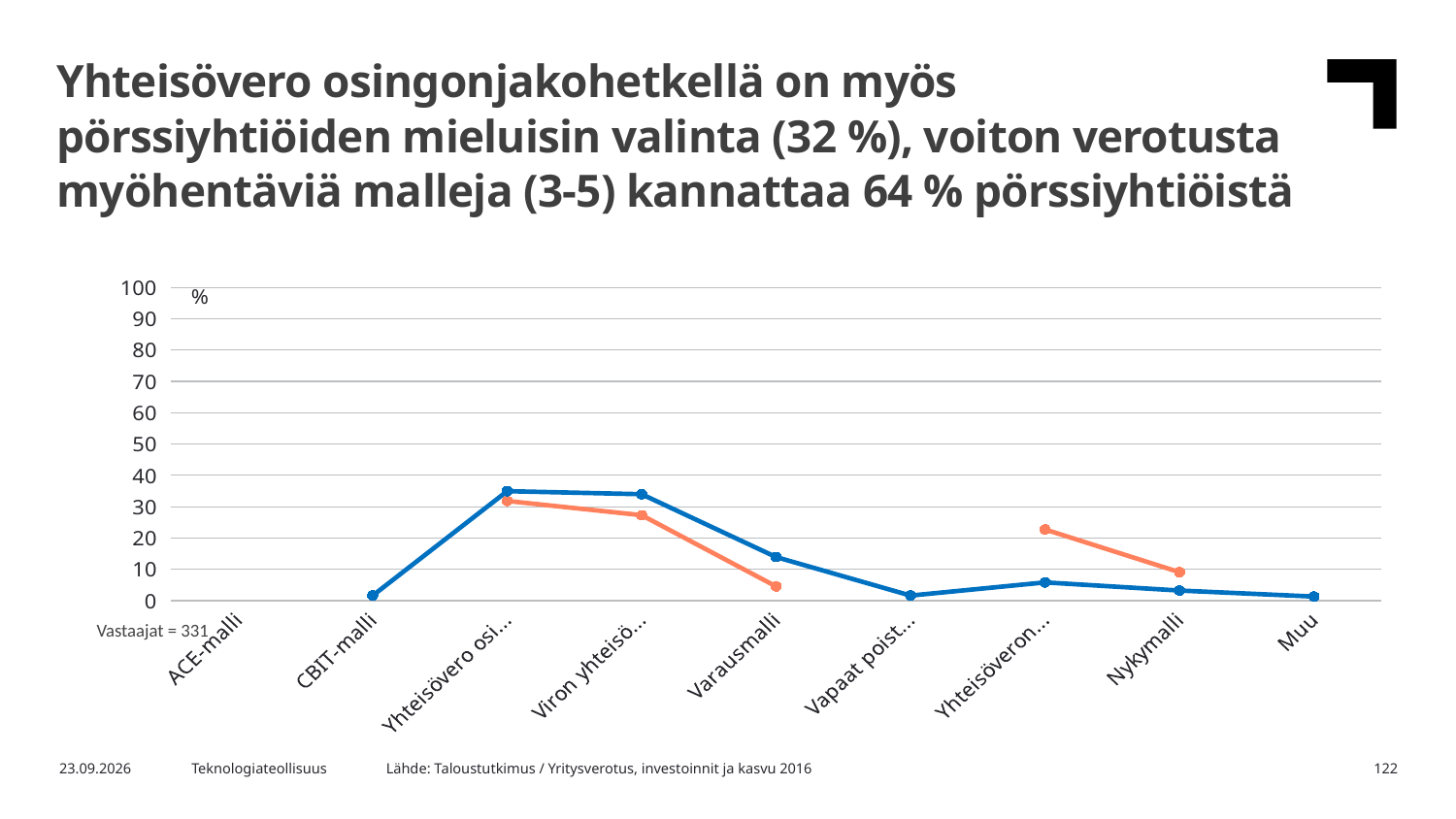
Is the value of the orange line for 'Varausmalli' greater or less than 10? less How many lines (series) are plotted on the chart? 2 For the orange line, which category has the highest value? Yhteisövero osi... How many categories are shown on the x axis of the chart? 9 Is the value of the blue line for 'Varausmalli' greater or less than 20? less Does the blue line rise or fall from 'Viron yhteisö...' to 'Vapaat poist...'? fall What unit is shown at the top of the y axis? % What kind of chart is shown on the slide? line chart At 'Viron yhteisö...', which line has the larger value, the blue line or the orange line? the blue line Is the value of the blue line for 'Yhteisövero osi...' greater or less than 30? greater